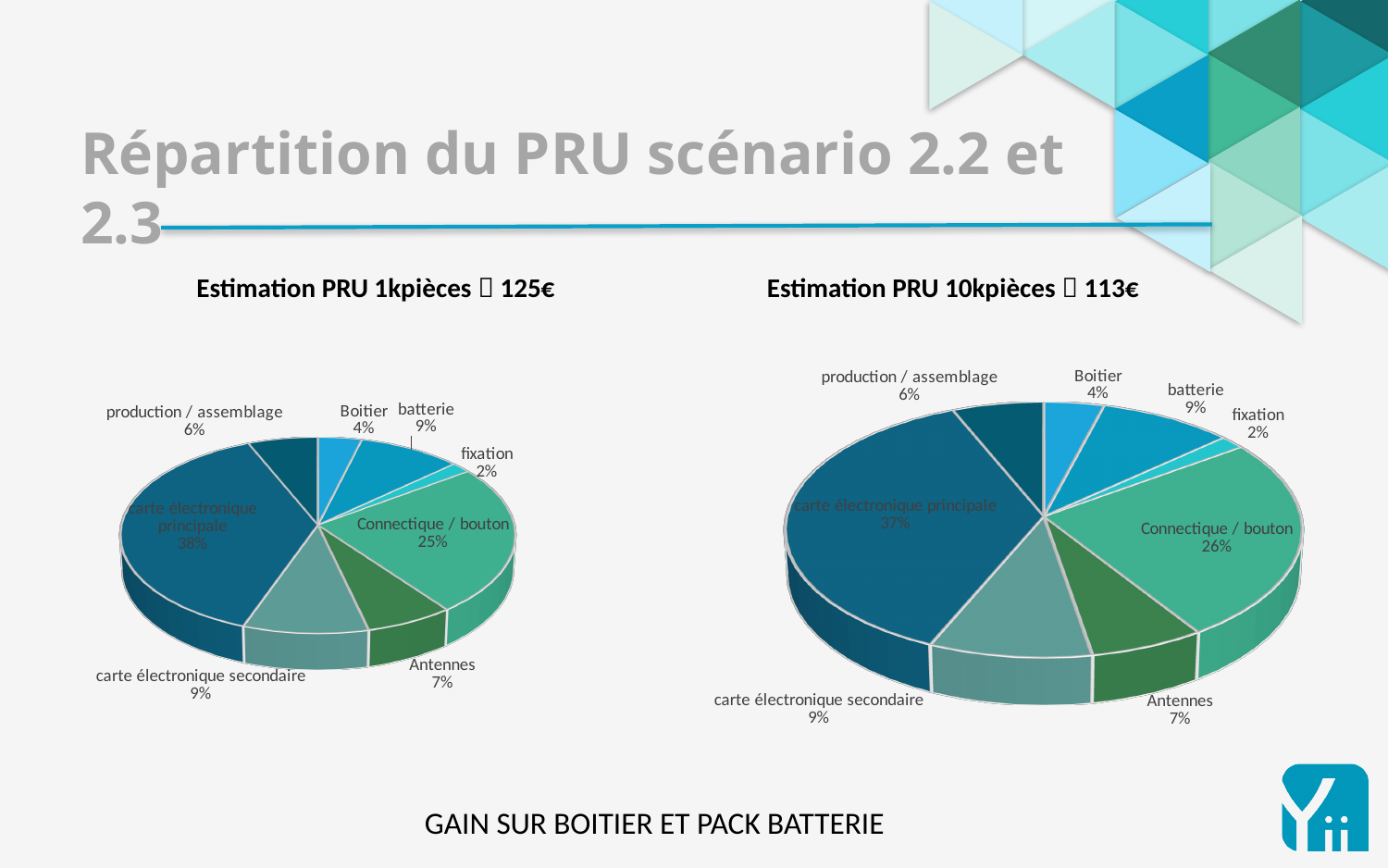
In the left chart (Estimation PRU 1kpièces), what share does carte électronique principale have? 38% What is the title of the right chart? Estimation PRU 10kpièces 113€ What is the difference between the share of carte électronique principale in the left chart (38%) and in the right chart (37%)? 1% In the left chart (Estimation PRU 1kpièces), which is larger: the share of Antennes or the share of Boitier? Antennes In the left chart (Estimation PRU 1kpièces), what is the combined share of Boitier and batterie? 13% In the right chart (Estimation PRU 10kpièces), which category has the largest share? carte électronique principale How many categories are shown in the right chart (Estimation PRU 10kpièces)? 8 In the right chart (Estimation PRU 10kpièces), what share does Connectique / bouton have? 26% What type of chart is the left chart (Estimation PRU 1kpièces)? Pie chart In the left chart (Estimation PRU 1kpièces), which category has the smallest share? fixation In the left chart (Estimation PRU 1kpièces), what share does fixation have? 2% In the right chart (Estimation PRU 10kpièces), what share does batterie have? 9%